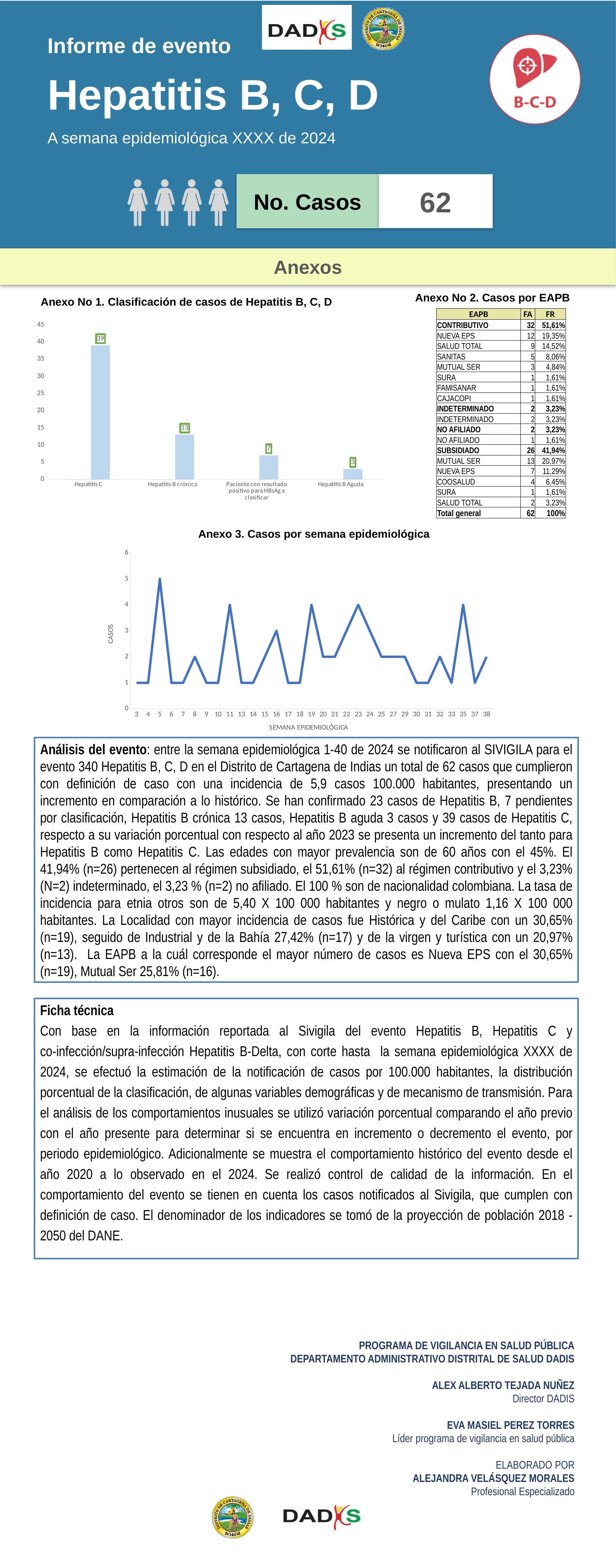
In the chart 'Anexo No 1. Clasificación de casos de Hepatitis B, C, D', which category has the lowest value? Hepatitis B Aguda In the chart 'Anexo No 1. Clasificación de casos de Hepatitis B, C, D', what is the value for Hepatitis B crónica? 13 In the chart 'Anexo 3. Casos por semana epidemiológica', which epidemiological week has the highest number of cases? 5 What type of chart is 'Anexo 3. Casos por semana epidemiológica'? Line chart In the chart 'Anexo No 1. Clasificación de casos de Hepatitis B, C, D', is the value for 'Paciente con resultado positivo para HBsAg a clasificar' greater or less than 10? less In the chart 'Anexo 3. Casos por semana epidemiológica', what is the label of the y axis? CASOS In the chart 'Anexo 3. Casos por semana epidemiológica', how many cases are shown for week 5? 5 What type of chart is 'Anexo No 1. Clasificación de casos de Hepatitis B, C, D'? Bar chart In the chart 'Anexo No 1. Clasificación de casos de Hepatitis B, C, D', what is the difference between Hepatitis C and Hepatitis B crónica? 26 In the chart 'Anexo No 1. Clasificación de casos de Hepatitis B, C, D', how many categories are shown? 4 In the chart 'Anexo No 1. Clasificación de casos de Hepatitis B, C, D', what is the value for Hepatitis C? 39 In the chart 'Anexo No 1. Clasificación de casos de Hepatitis B, C, D', which category has the highest value? Hepatitis C